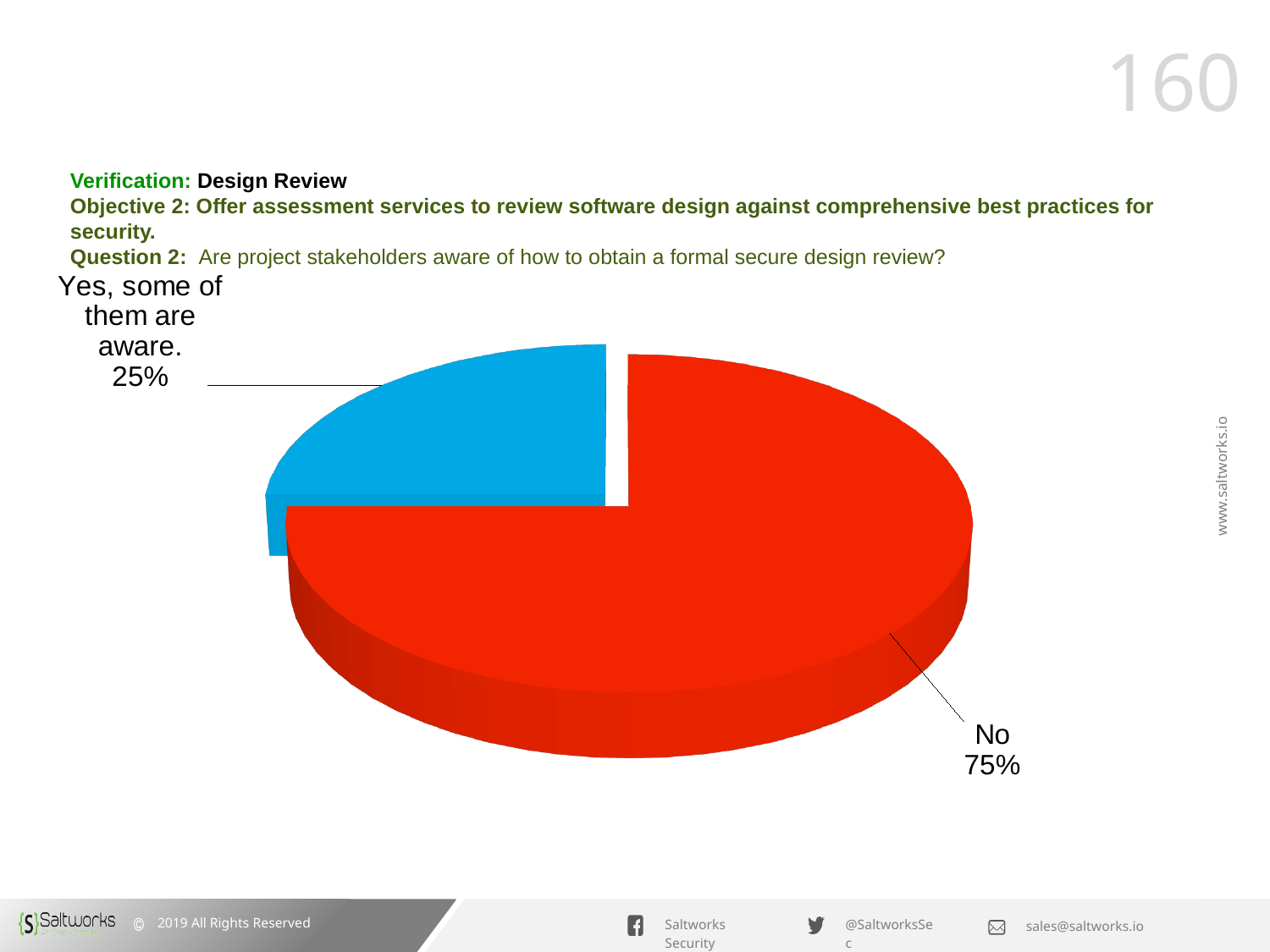
What share of the pie does the "No" slice represent? 75% What colour is the "Yes, some of them are aware." slice of the pie? Blue How many slices does the pie chart have? 2 What colour is the "No" slice of the pie? Red Which slice of the pie is the largest? No What percentage of the pie is labelled "No"? 75% Which slice of the pie is the smallest? Yes, some of them are aware. What kind of chart is shown on the slide? Pie chart Which is larger: the "No" slice or the "Yes, some of them are aware." slice? No What is the difference in percentage points between the "No" slice and the "Yes, some of them are aware." slice? 50 What percentage of the pie is labelled "Yes, some of them are aware."? 25%